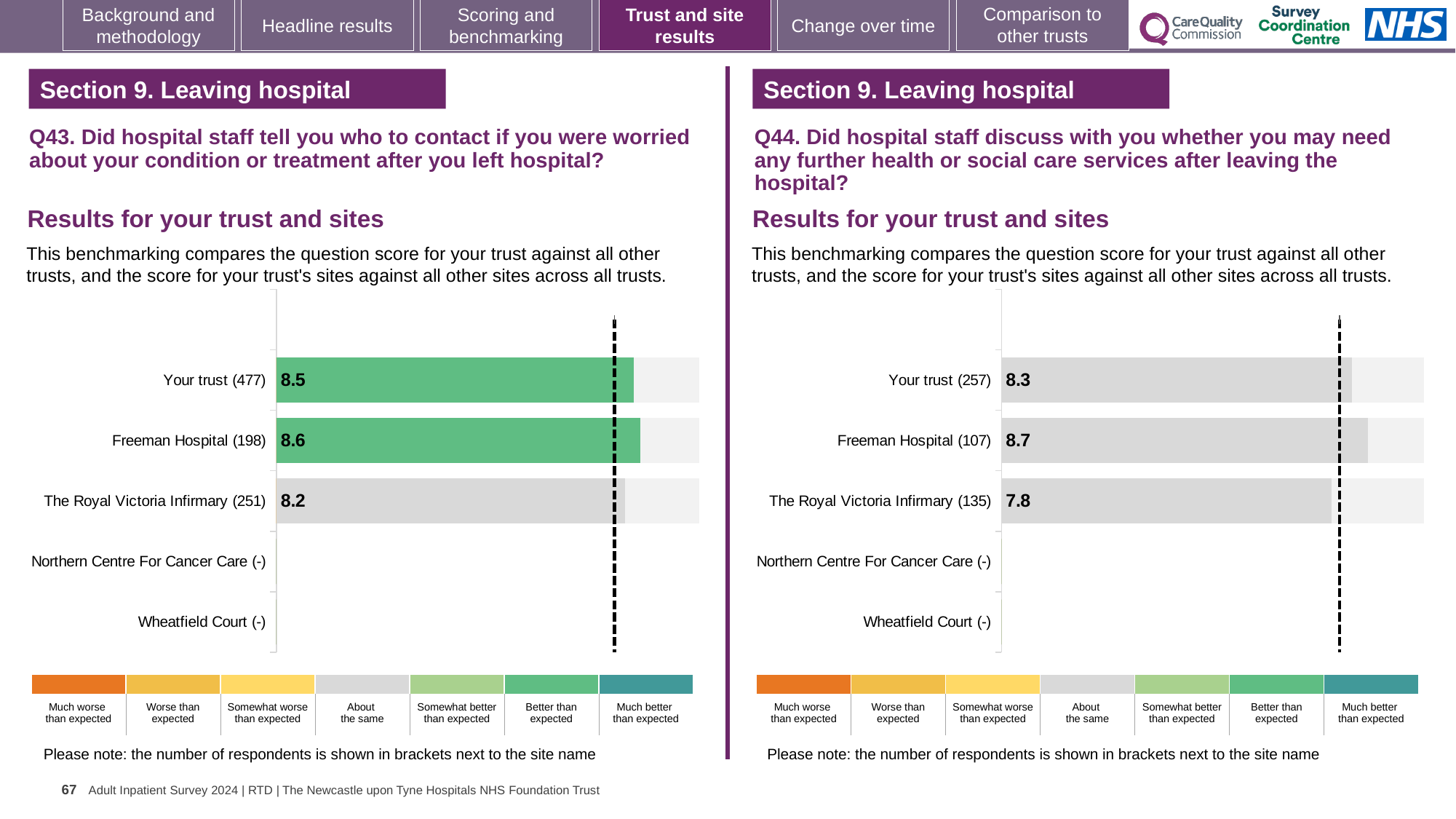
In the Q44 chart on the right, what is the difference between the scores for Freeman Hospital and The Royal Victoria Infirmary? 0.9 In the Q43 chart on the left, which benchmark category does the colour of the Your trust bar correspond to? Better than expected In the Q43 chart on the left, what is the score for The Royal Victoria Infirmary? 8.2 In the Q43 chart on the left, how many respondents are shown for Freeman Hospital? 198 In the Q43 chart on the left, which site or trust has the lowest score? The Royal Victoria Infirmary In the Q44 chart on the right, what is the score for Your trust? 8.3 In the Q43 chart on the left, what is the score for Freeman Hospital? 8.6 In the Q44 chart on the right, what is the score for The Royal Victoria Infirmary? 7.8 What type of chart is used in the Q44 chart on the right? Bar chart In the Q43 chart on the left, what is the score for Your trust? 8.5 In the Q43 chart on the left, which has the higher score, Your trust or Freeman Hospital? Freeman Hospital In the Q44 chart on the right, which site or trust has the highest score? Freeman Hospital